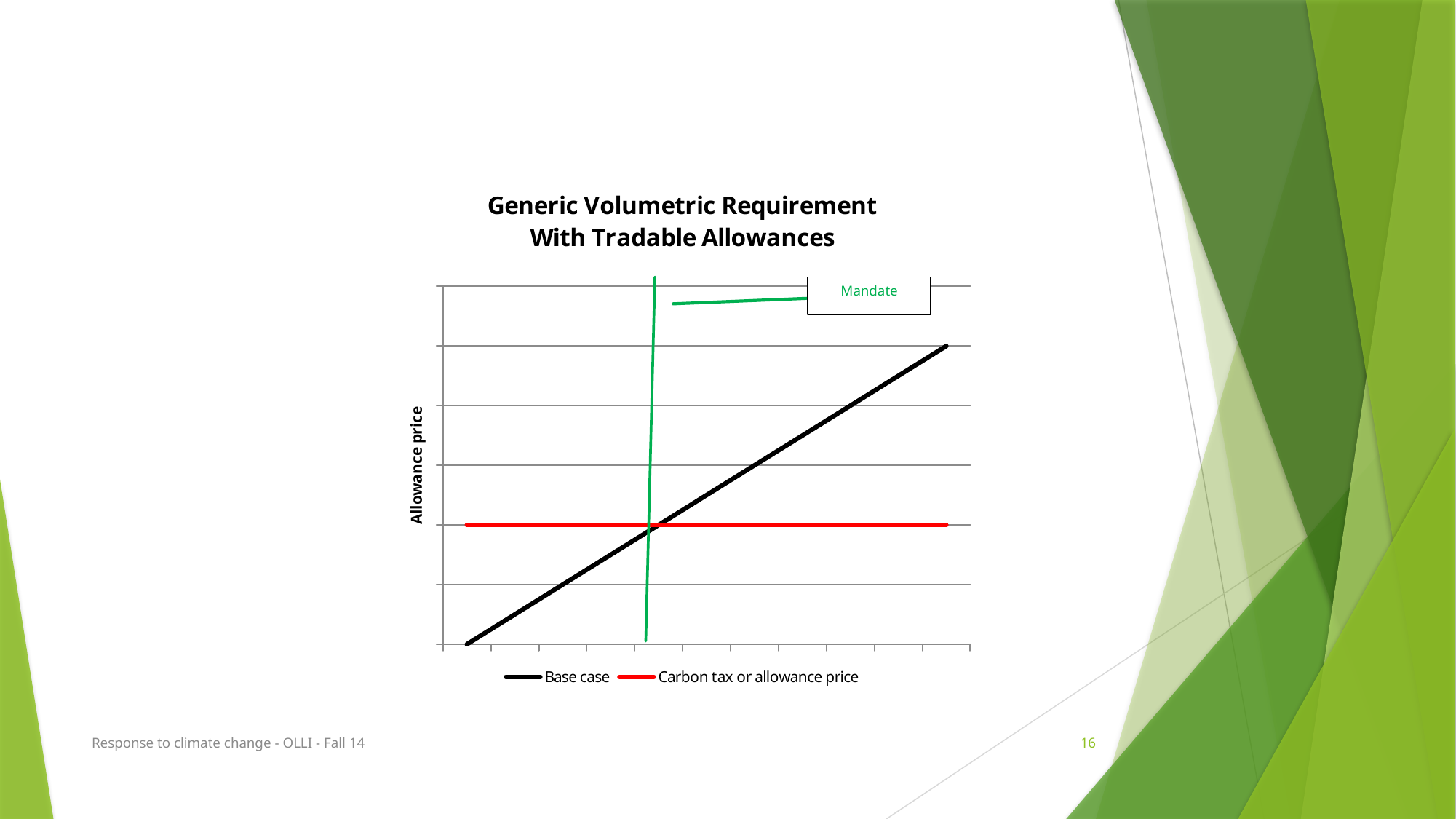
How many series does the chart's legend list? 2 What is the title of the chart? Generic Volumetric Requirement With Tradable Allowances Does the Carbon tax or allowance price line rise, fall, or stay flat along the x axis? Stays flat Does the Base case line rise or fall as it moves along the x axis? Rises What kind of chart is shown on the slide? Line chart What label is shown on the chart's vertical axis? Allowance price